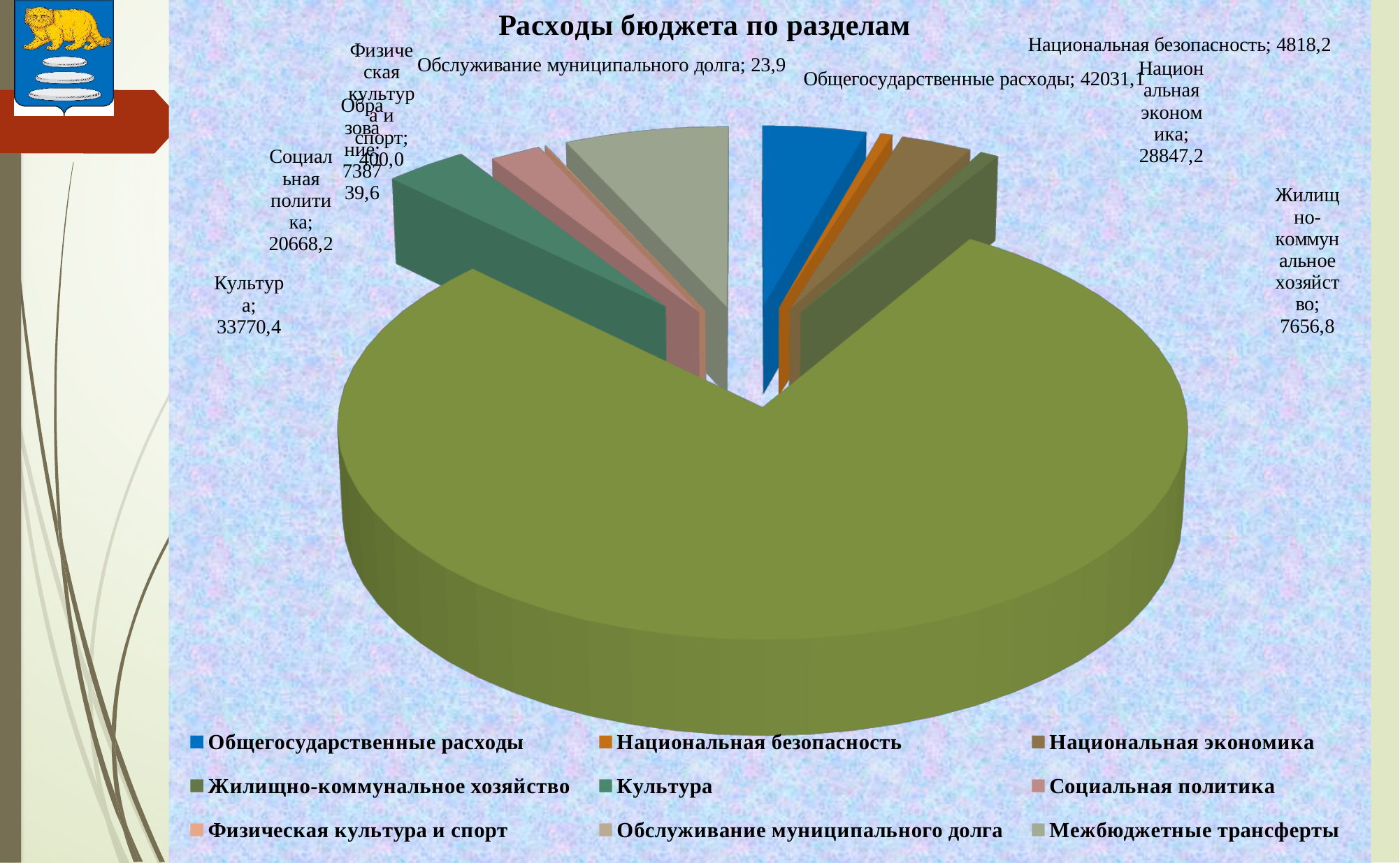
Which is larger, Национальная экономика or Социальная политика? Национальная экономика What is the value for Общегосударственные расходы? 42031,1 What is the value for Национальная экономика? 28847,2 Which of the labelled categories has the smallest value? Обслуживание муниципального долга How many entries does the legend list? 9 What is the title of the chart? Расходы бюджета по разделам What is the difference between Общегосударственные расходы and Культура? 8260,7 What is the value for Культура? 33770,4 What is the value for Жилищно-коммунальное хозяйство? 7656,8 What is the value for Обслуживание муниципального долга? 23,9 What is the value for Национальная безопасность? 4818,2 What kind of chart is shown on the slide? Pie chart